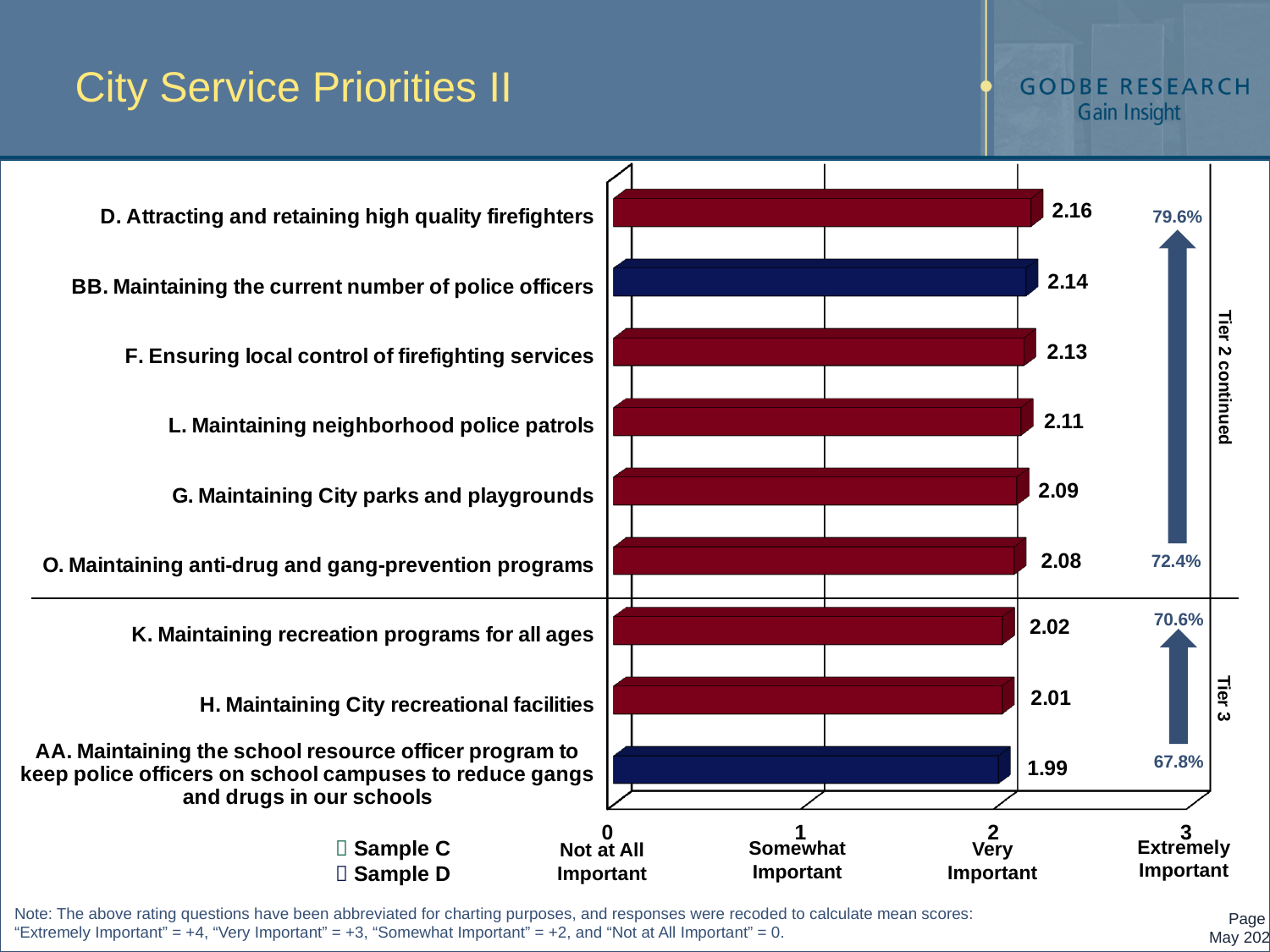
What label is shown at the value 3 on the axis? Extremely Important What kind of chart is shown on the slide? Bar chart What is the mean score for AA. Maintaining the school resource officer program to keep police officers on school campuses to reduce gangs and drugs in our schools? 1.99 Which item has the highest mean score? D. Attracting and retaining high quality firefighters What is the mean score for G. Maintaining City parks and playgrounds? 2.09 How many entries does the legend list? 2 Which item has the lowest mean score? AA. Maintaining the school resource officer program to keep police officers on school campuses to reduce gangs and drugs in our schools How many items are plotted in the chart? 9 What is the mean score for D. Attracting and retaining high quality firefighters? 2.16 Which has a higher mean score: BB. Maintaining the current number of police officers or H. Maintaining City recreational facilities? BB. Maintaining the current number of police officers Is the mean score for L. Maintaining neighborhood police patrols greater or less than 2? greater What is the difference between the mean scores for D. Attracting and retaining high quality firefighters and K. Maintaining recreation programs for all ages? 0.14